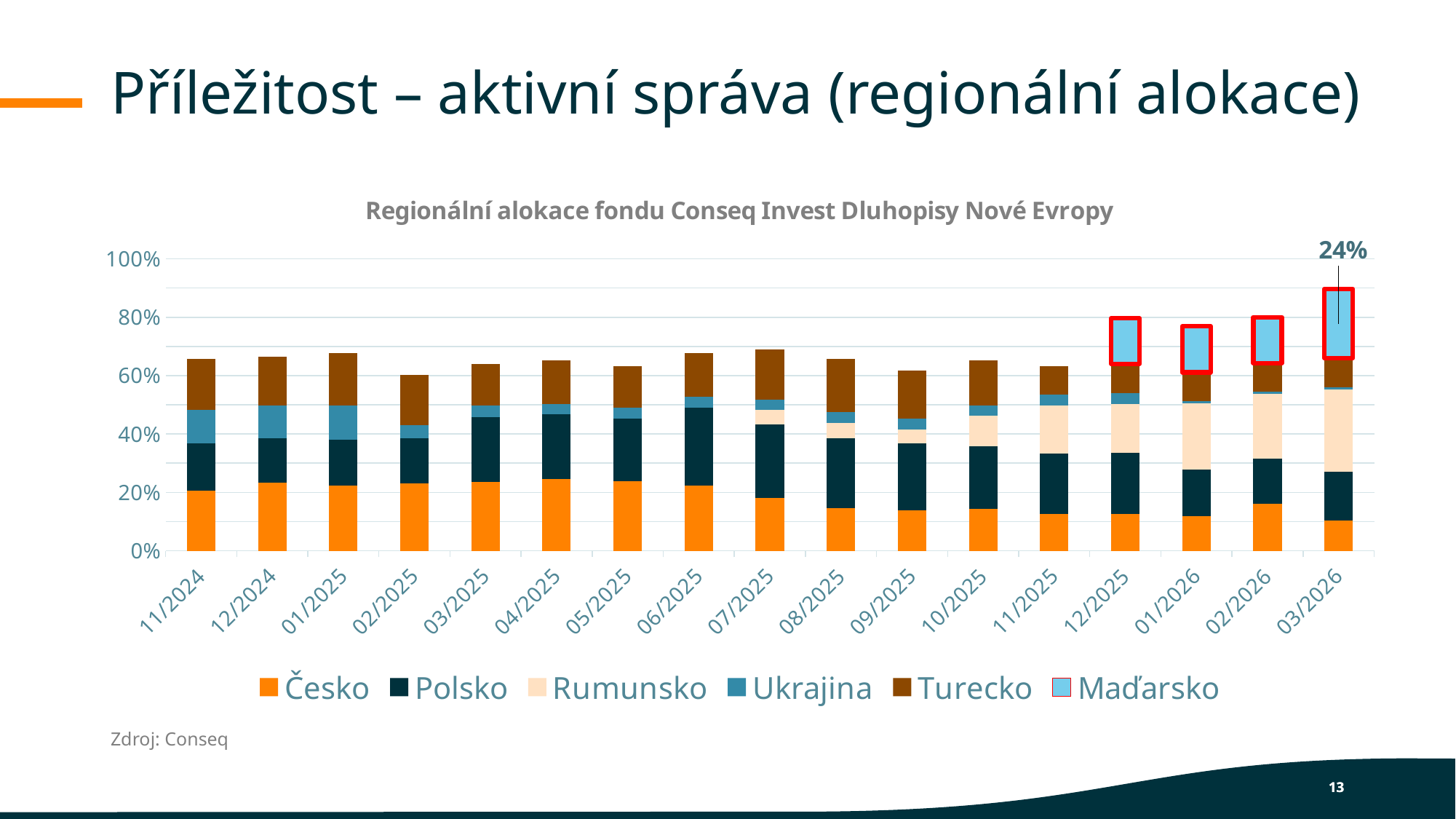
What is the title of the chart? Regionální alokace fondu Conseq Invest Dluhopisy Nové Evropy How many series does the legend list? 6 Which series is highlighted with a red outline in the chart? Maďarsko Does the Ukrajina segment rise or fall from 11/2024 to 03/2026? fall What is the value of the Maďarsko segment in 03/2026? 24% How many months are shown on the x axis? 17 Is the Česko segment in 03/2026 greater or less than 20%? less Is the total stacked bar for 11/2024 greater or less than 80%? less What kind of chart is shown on the slide? bar chart Is the total stacked bar for 03/2026 greater or less than 80%? greater Which is larger, the Česko segment in 04/2025 or in 03/2026? 04/2025 Which month has the highest total stacked bar? 03/2026